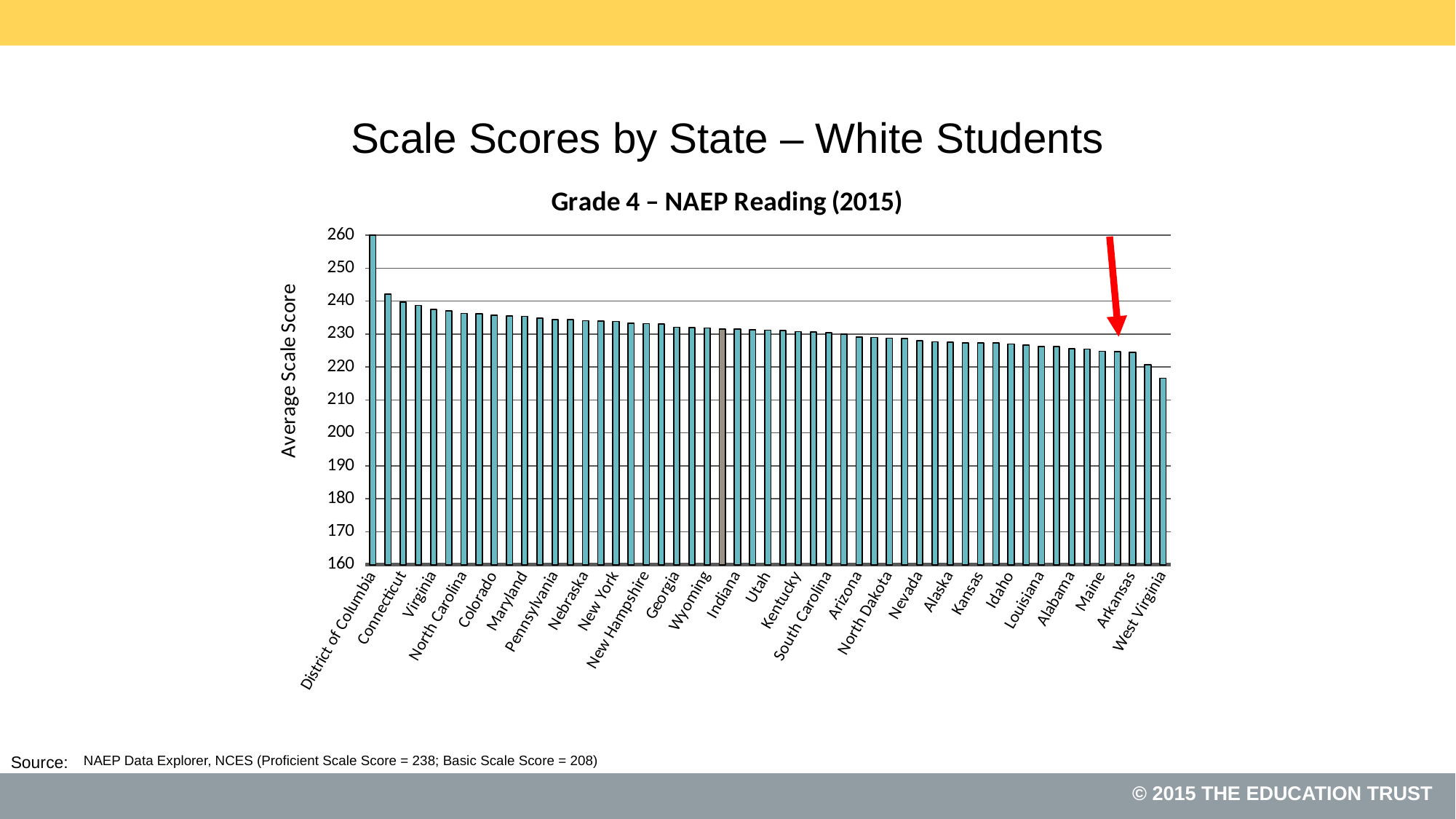
Is the value for West Virginia greater or less than 220? less Is the value for District of Columbia greater or less than 250? greater Which state has the lowest average scale score? West Virginia What is the label on the vertical axis of the chart? Average Scale Score Which has a higher average scale score, Virginia or Arkansas? Virginia Which state has the highest average scale score? District of Columbia Is the value for Kansas greater or less than 230? less Do the values rise or fall moving from left to right along the x axis? fall What kind of chart is shown on the slide? bar chart Which has a higher average scale score, Connecticut or West Virginia? Connecticut